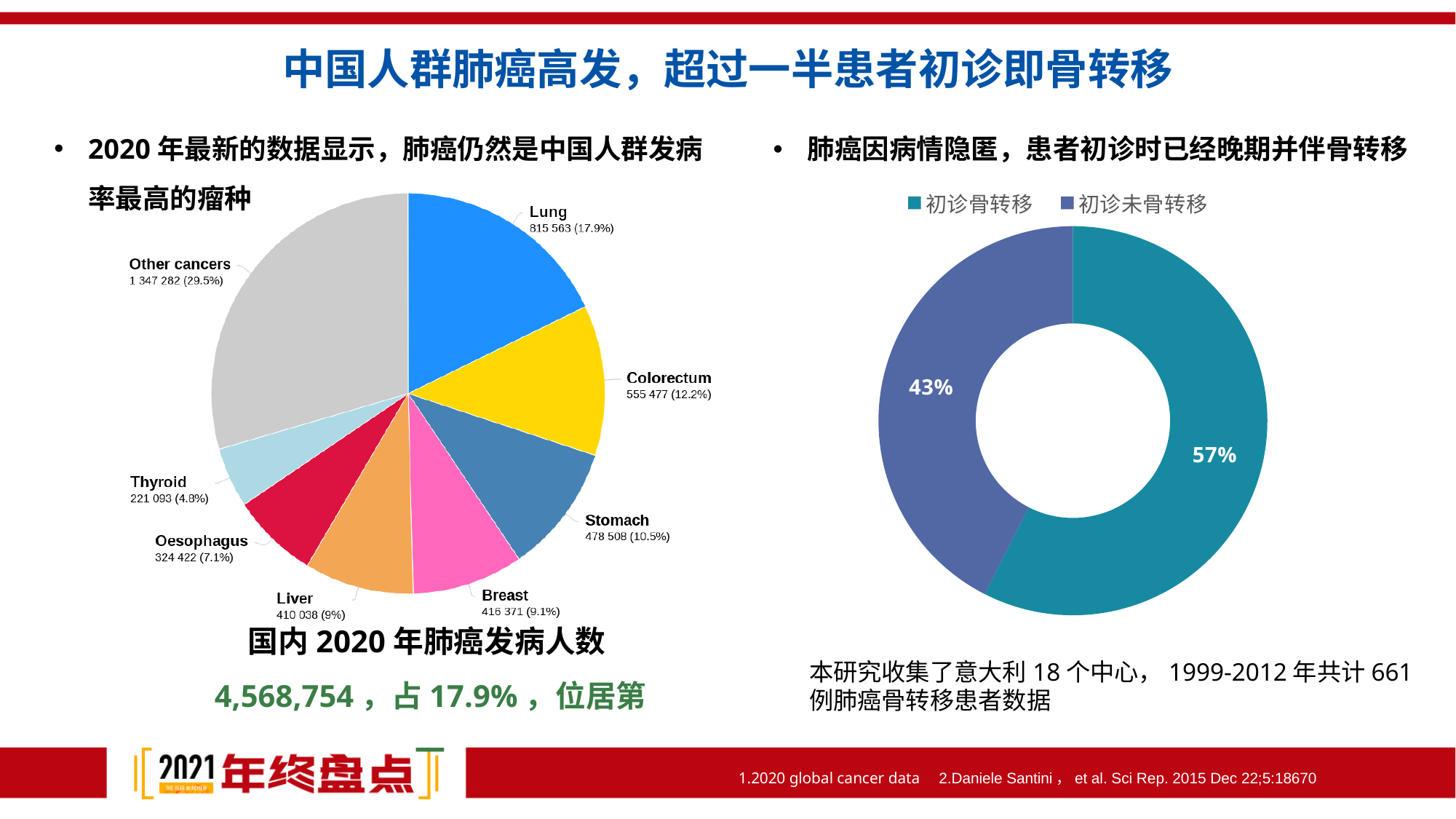
In the right donut chart, what percentage is shown for 初诊骨转移? 57% In the left pie chart, what is the number shown for Stomach? 478 508 How many slices does the left pie chart have? 8 In the left pie chart, what is the difference in percentage points between Lung (17.9%) and Colorectum (12.2%)? 5.7 What type of chart is the chart on the left of the slide? Pie chart In the left pie chart, what is the value shown for Lung? 815 563 (17.9%) In the left pie chart, which category has the smallest slice? Thyroid How many entries does the legend of the right donut chart list? 2 In the right donut chart, what is the difference between the 初诊骨转移 and 初诊未骨转移 shares? 14% In the left pie chart, which named cancer type (excluding Other cancers) has the largest slice? Lung In the left pie chart, which is larger, the Breast slice or the Oesophagus slice? Breast In the left pie chart, what percentage is shown for Colorectum? 12.2%